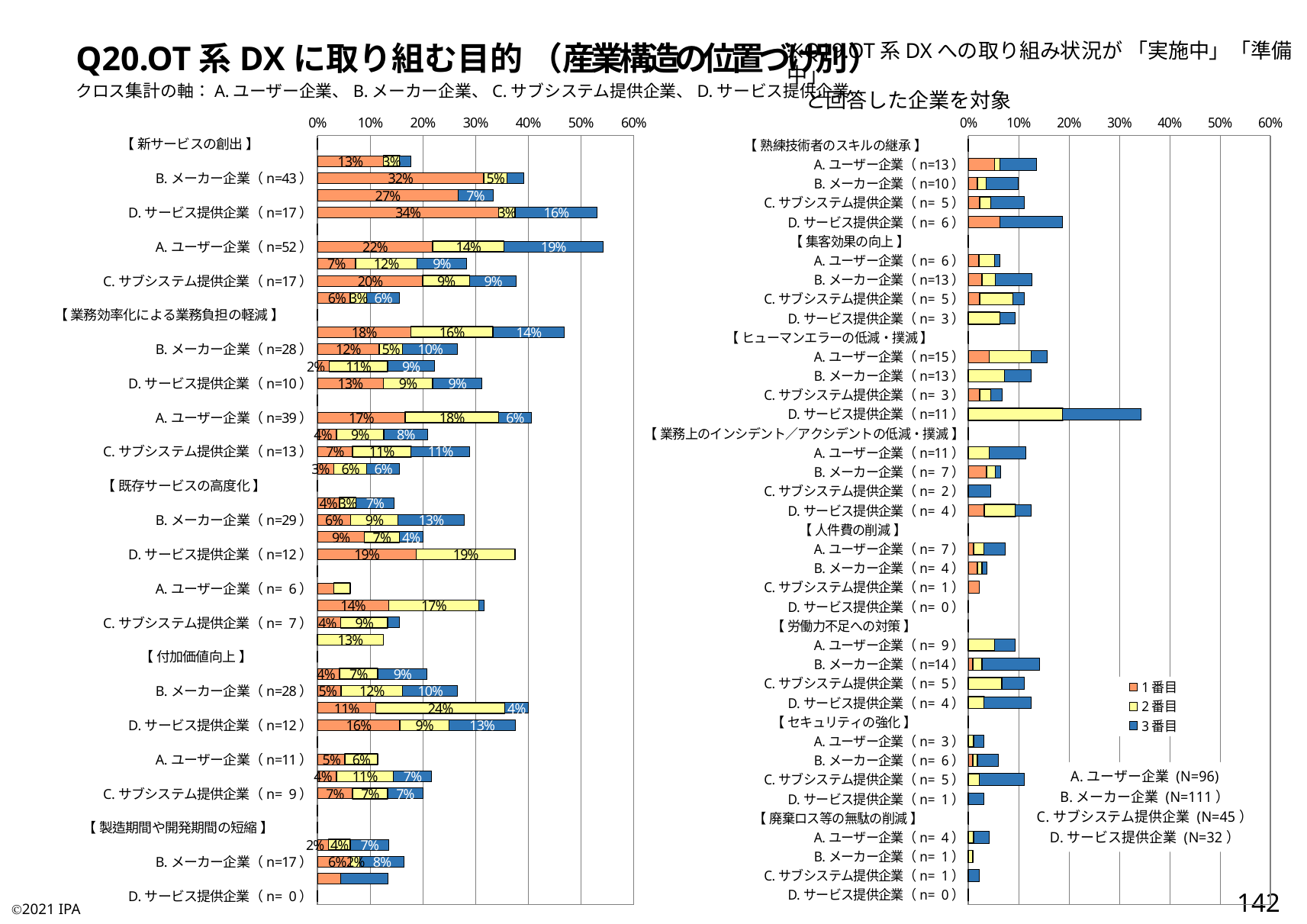
In the left chart, under 【新サービスの創出】, what is the 1番目 value for A. ユーザー企業 (n=52)? 22% In the left chart, under 【新サービスの創出】, what is the 3番目 value for D. サービス提供企業 (n=17)? 16% In the left chart, under 【付加価値向上】, what is the 1番目 value for C. サブシステム提供企業 (n=9)? 7% How many series does the legend list? 3 What are the three legend entries? 1番目, 2番目, 3番目 In the left chart, under 【新サービスの創出】, what is the total of the stacked bar for A. ユーザー企業 (n=52)? 55% In the left chart, under 【業務効率化による業務負担の軽減】, what is the 2番目 value for A. ユーザー企業 (n=39)? 18% What is the maximum value shown on the percentage axis of the charts? 60% In the right chart, under 【ヒューマンエラーの低減・撲滅】, is the total bar length for D. サービス提供企業 (n=11) greater or less than 30%? greater In the left chart, under 【新サービスの創出】, which has the larger 1番目 value: B. メーカー企業 (n=43) or D. サービス提供企業 (n=17)? D. サービス提供企業 (n=17) What kind of chart is used on this slide? bar chart In the left chart, under 【業務効率化による業務負担の軽減】, what is the difference between the 2番目 and 3番目 values for A. ユーザー企業 (n=39)? 12%